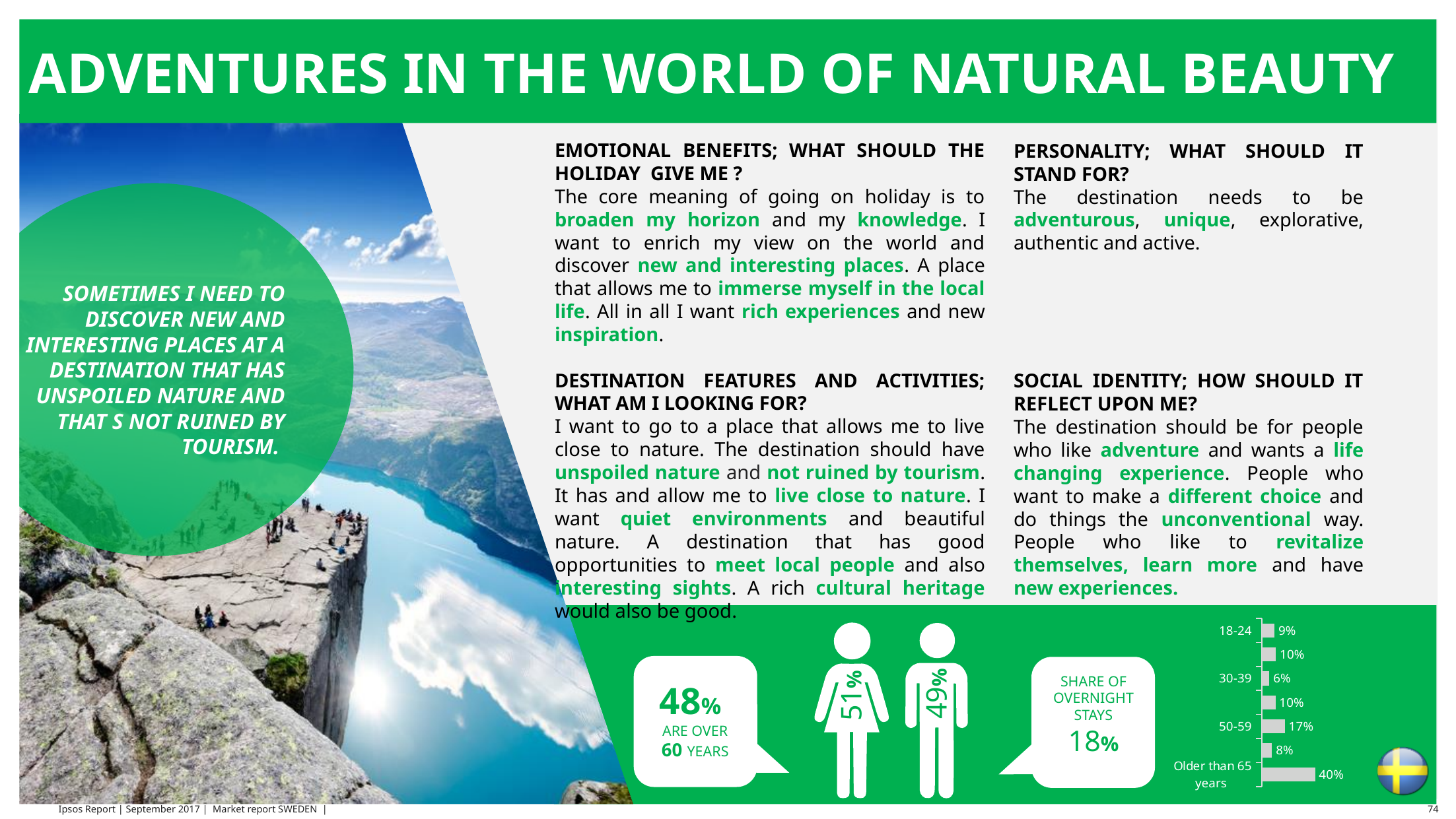
What colour are the bars in the age bar chart? Grey In the age bar chart, which age group has the highest value? Older than 65 years In the age bar chart, which is larger: the value for 50-59 or the value for 18-24? 50-59 In the age bar chart, what is the value for the 50-59 age group? 17% In the age bar chart, what is the difference between the 18-24 value and the 30-39 value? 3% In the age bar chart, what is the value for the 'Older than 65 years' group? 40% In the age bar chart, what is the difference between the 'Older than 65 years' value and the 50-59 value? 23% What kind of chart is shown at the bottom right of the slide? Bar chart How many bars are plotted in the age bar chart? 7 In the age bar chart, what is the value for the 30-39 age group? 6% In the age bar chart, which age group has the lowest value? 30-39 In the age bar chart, what is the value for the 18-24 age group? 9%